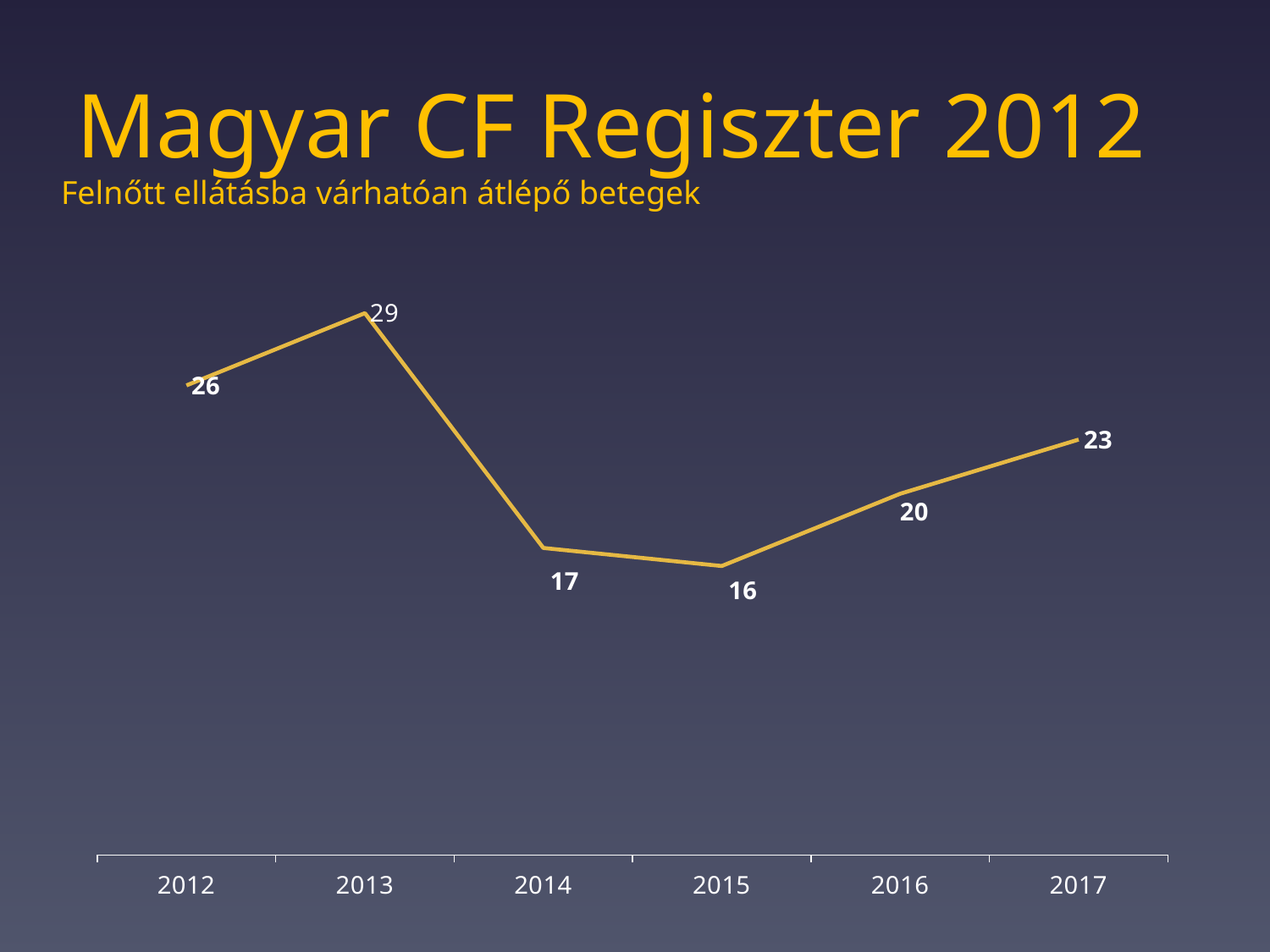
What is the value for 2012? 26 Which year has the lowest value? 2015 Which year has the highest value? 2013 How many years are plotted on the x axis? 6 What is the value for 2017? 23 What is the difference between the values for 2017 and 2016? 3 What kind of chart is shown on the slide? line chart What is the difference between the values for 2013 and 2015? 13 What is the value for 2015? 16 What is the value for 2013? 29 Do the values rise or fall from 2015 to 2017? rise Which is larger, the value for 2012 or the value for 2017? 2012